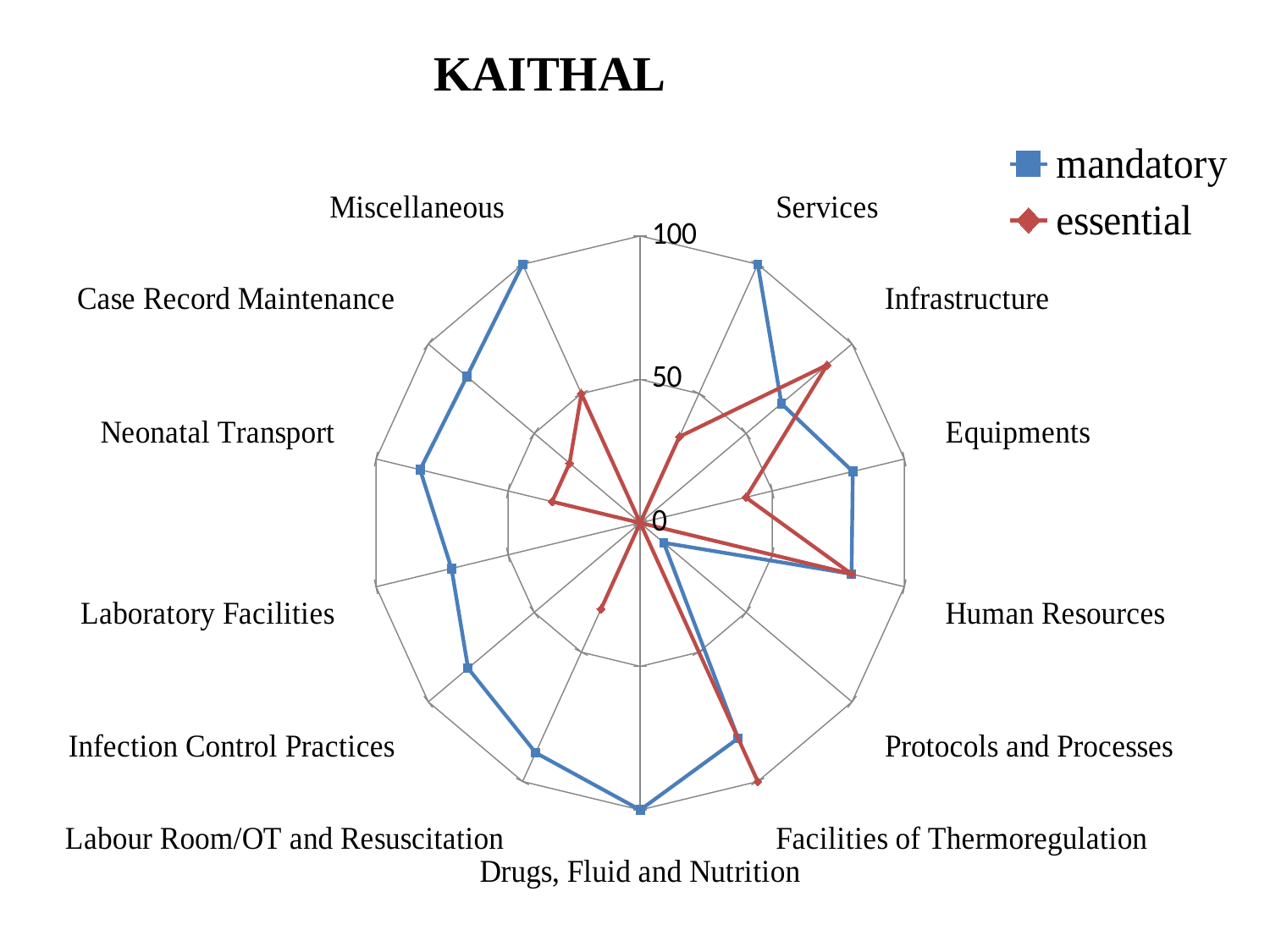
For Infrastructure, which series has the larger value, mandatory or essential? essential Is the mandatory value for Services greater or less than 50? greater Which series is drawn in red with diamond markers? essential Is the essential value for Infrastructure greater or less than 50? greater What kind of chart is shown on the slide? Radar chart Is the essential value for Neonatal Transport greater or less than 50? less For Equipments, which series has the larger value, mandatory or essential? mandatory How many categories (axes) does the radar chart have? 14 What is the title of the chart? KAITHAL How many series does the legend list? 2